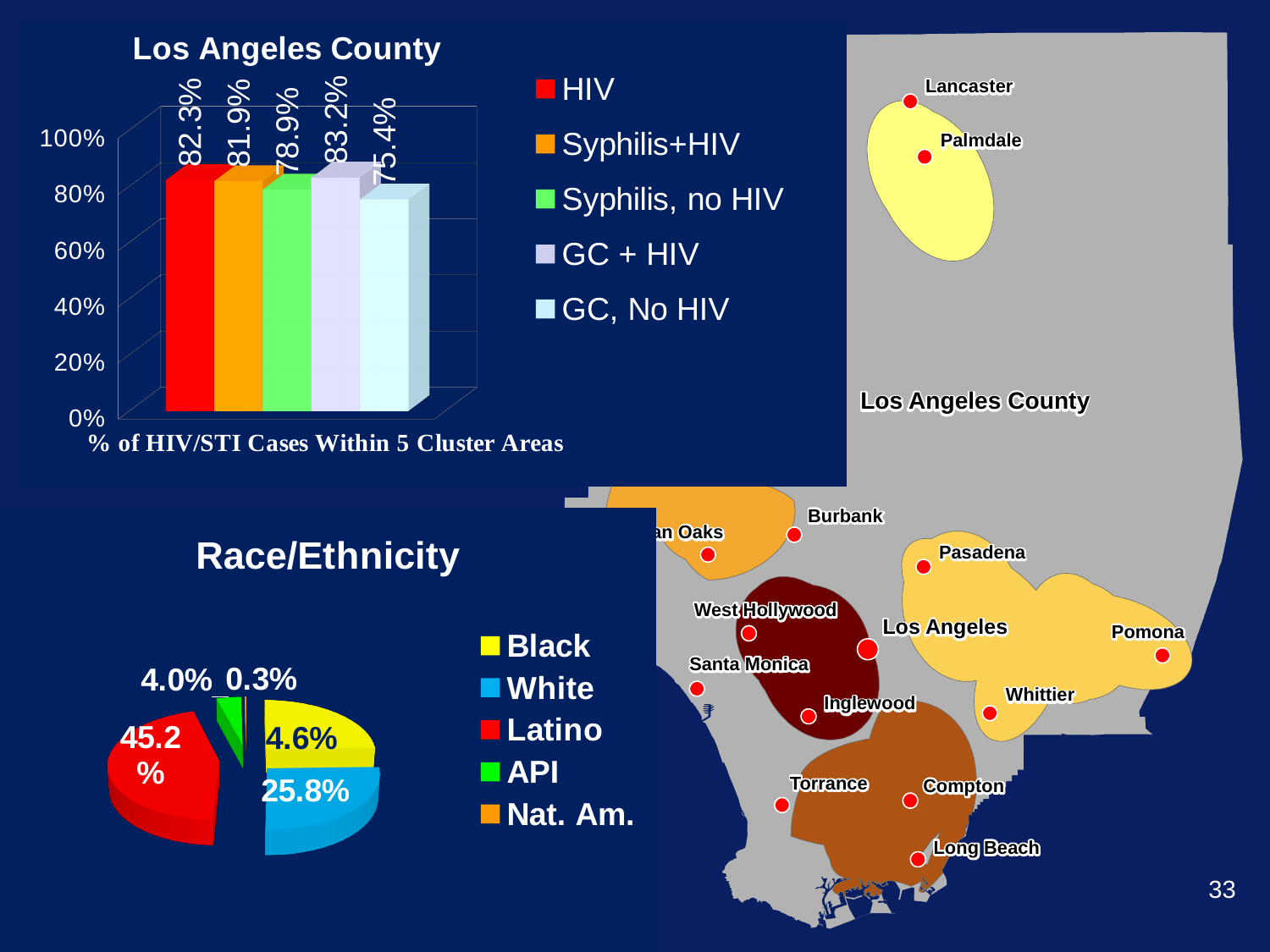
In the Los Angeles County bar chart, what is the difference between the HIV value and the GC, No HIV value? 6.9% In the Los Angeles County bar chart, what is the value for GC + HIV? 83.2% In the Los Angeles County bar chart, which series has the lowest value? GC, No HIV What kind of chart is the Los Angeles County chart? Bar chart In the Race/Ethnicity pie chart, which is larger, the Latino slice or the White slice? Latino In the Los Angeles County bar chart, how many series does the legend list? 5 In the Los Angeles County bar chart, what is the value for Syphilis+HIV? 81.9% In the Race/Ethnicity pie chart, what is the value for Latino? 45.2% In the Race/Ethnicity pie chart, which category has the smallest slice? Nat. Am. In the Los Angeles County bar chart, which series has the highest value? GC + HIV In the Los Angeles County bar chart, what is the value for HIV? 82.3% In the Race/Ethnicity pie chart, what is the value for White? 25.8%